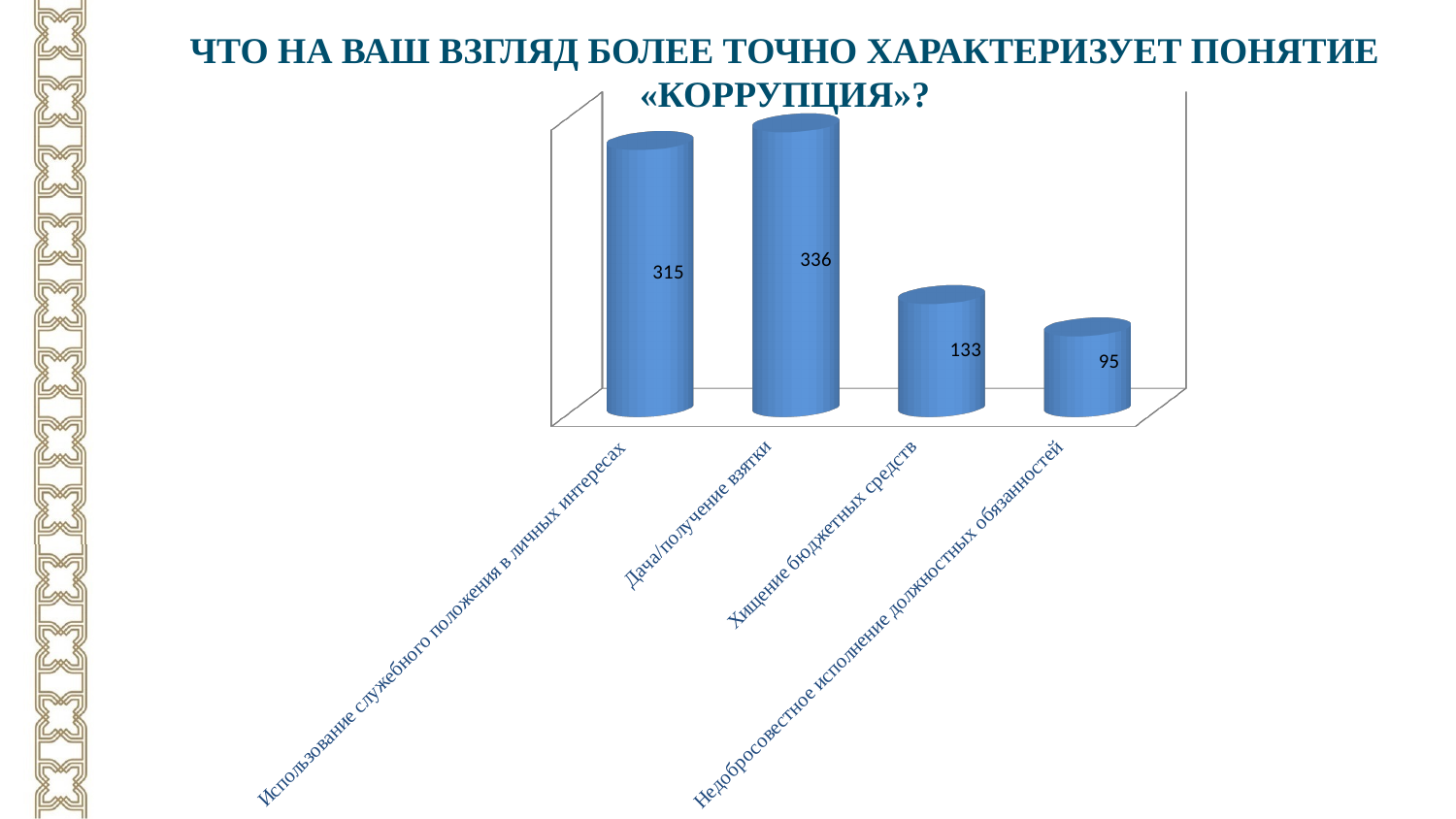
Which category has the lowest value? Недобросовестное исполнение должностных обязанностей What is the value for «Хищение бюджетных средств»? 133 What is the value for «Использование служебного положения в личных интересах»? 315 Which category has the highest value? Дача/получение взятки How many categories are shown in the chart? 4 What is the difference between the values for «Хищение бюджетных средств» and «Недобросовестное исполнение должностных обязанностей»? 38 What kind of chart is shown on the slide? Bar chart What is the value for «Недобросовестное исполнение должностных обязанностей»? 95 What is the value for «Дача/получение взятки»? 336 What is the title of the chart? ЧТО НА ВАШ ВЗГЛЯД БОЛЕЕ ТОЧНО ХАРАКТЕРИЗУЕТ ПОНЯТИЕ «КОРРУПЦИЯ»? What is the difference between the values for «Дача/получение взятки» and «Использование служебного положения в личных интересах»? 21 Which is larger: the value for «Хищение бюджетных средств» or for «Недобросовестное исполнение должностных обязанностей»? Хищение бюджетных средств